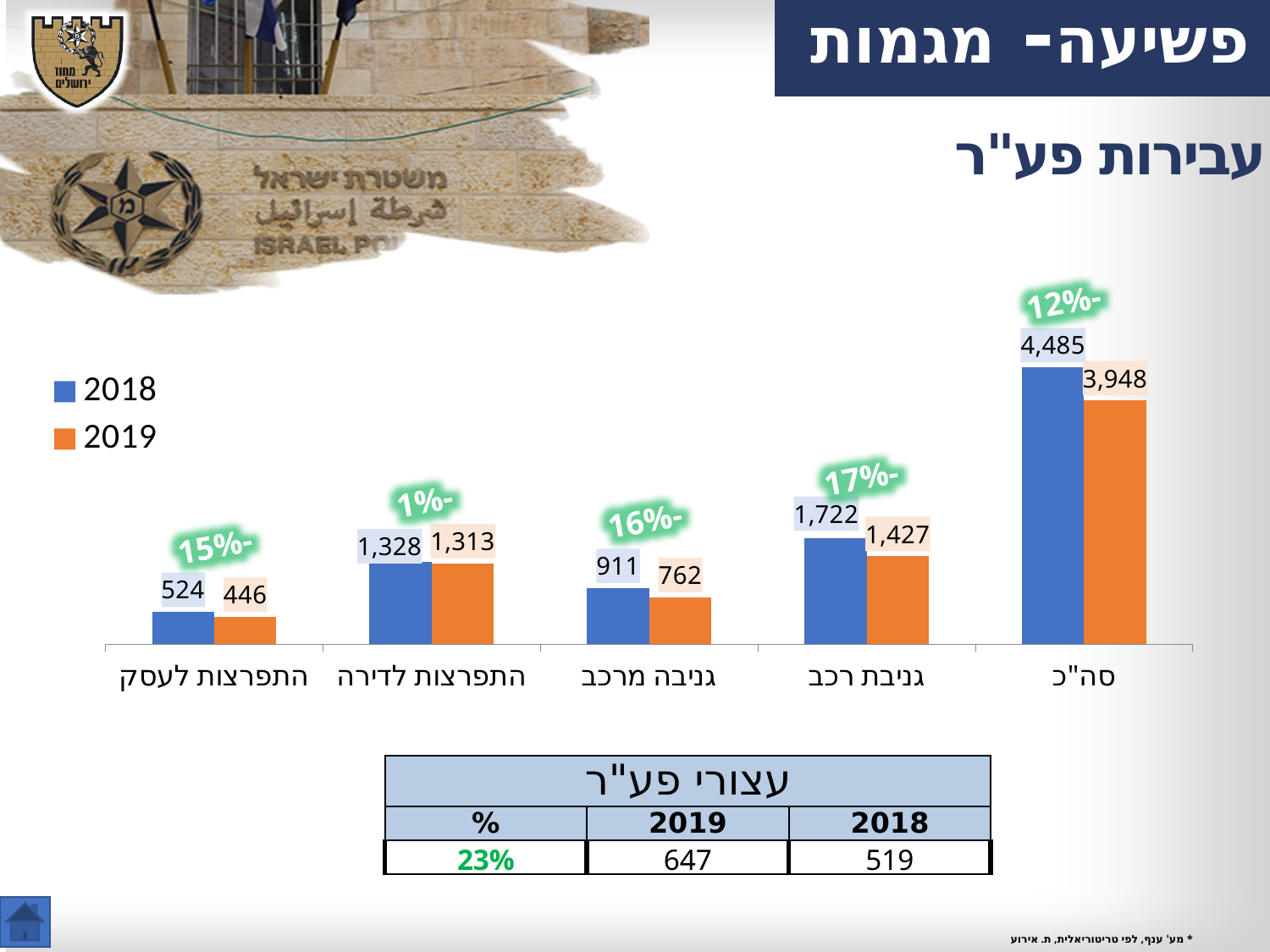
How many series does the legend list? 2 Excluding סה"כ, which category has the highest 2018 value? גניבת רכב Which is larger for התפרצות לדירה: the 2018 value or the 2019 value? 2018 What kind of chart is shown? bar chart What is the 2018 value for סה"כ? 4,485 What is the 2018 value for גניבה מרכב? 911 How many categories are shown on the x axis? 5 What is the 2019 value for גניבת רכב? 1,427 What is the difference between the 2018 and 2019 values for גניבה מרכב? 149 What is the 2019 value for התפרצות לעסק? 446 What percentage change label is shown above the סה"כ bars? 12%- Which category has the lowest 2019 value? התפרצות לעסק